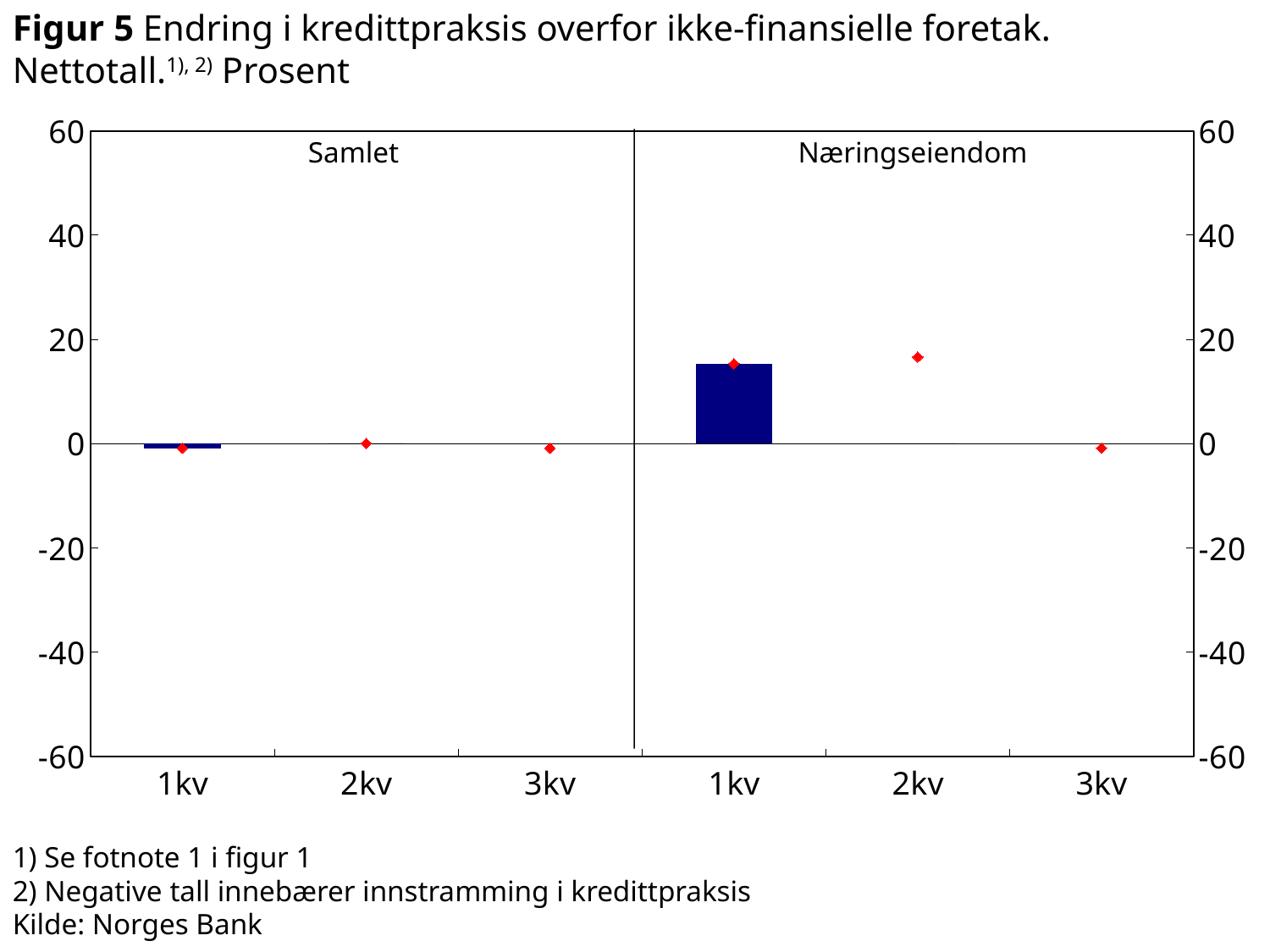
How many quarters are shown on the x axis within each panel? 3 Is the red marker for 2kv in the Næringseiendom panel greater or less than 20? less In which panel and quarter is the tallest bar found? Næringseiendom, 1kv What kind of chart is shown on the slide? bar chart with red diamond markers (combination bar and marker chart) Is the red marker for 2kv in the Næringseiendom panel greater or less than 0? greater Is the bar for 1kv in the Næringseiendom panel greater or less than 20? less Which is larger: the 1kv bar in the Samlet panel or the 1kv bar in the Næringseiendom panel? Næringseiendom What are the names of the two panels in the chart? Samlet and Næringseiendom How many panels (sections) does the chart have? 2 What is the maximum value shown on the y axis? 60